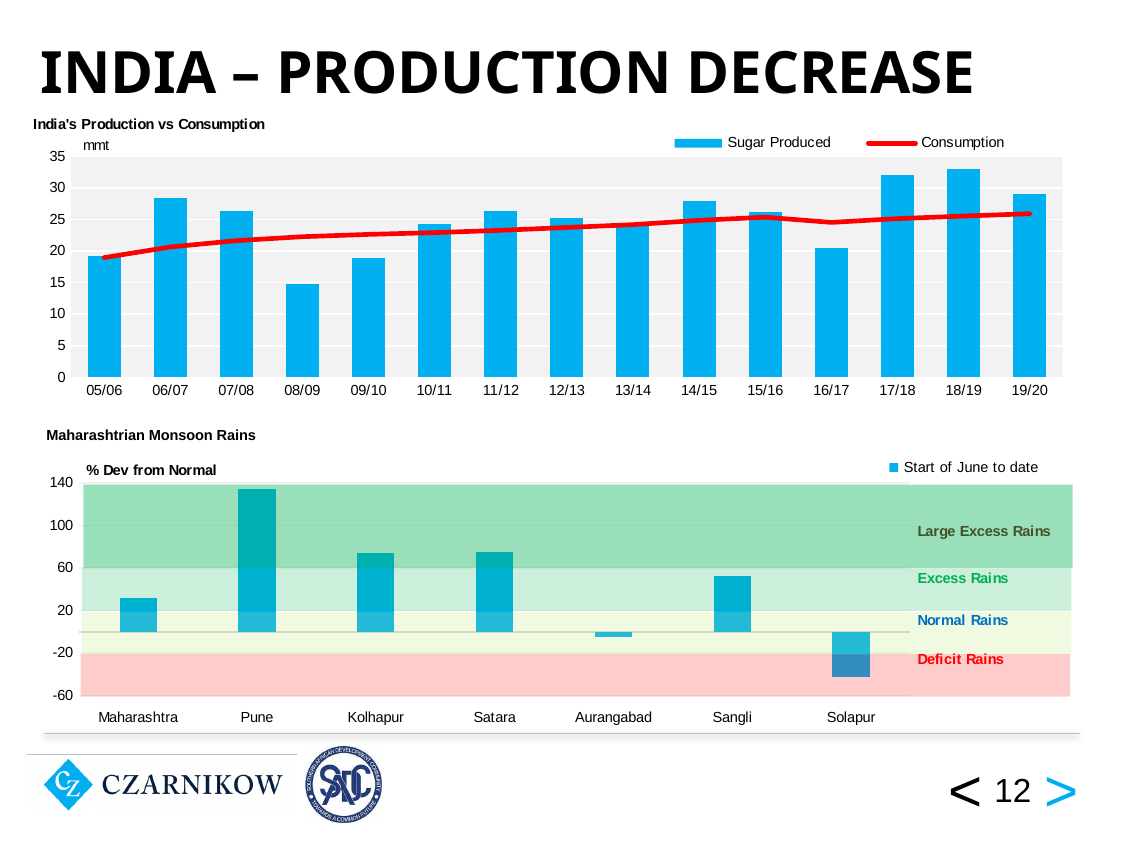
In the top chart, 'India's Production vs Consumption', is the Sugar Produced value for 08/09 greater or less than 20? less In the bottom chart, 'Maharashtrian Monsoon Rains', how many regions are shown on the x axis? 7 In the top chart, 'India's Production vs Consumption', which season has the highest Sugar Produced bar? 18/19 In the top chart, 'India's Production vs Consumption', which season has the lowest Sugar Produced bar? 08/09 In the bottom chart, 'Maharashtrian Monsoon Rains', which region has the highest % deviation from normal? Pune In the top chart, 'India's Production vs Consumption', what unit is shown on the y axis? mmt In the top chart, 'India's Production vs Consumption', how many seasons are shown on the x axis? 15 In the top chart, 'India's Production vs Consumption', is the Sugar Produced value for 18/19 greater or less than 30? greater In the top chart, 'India's Production vs Consumption', how many series does the legend list? 2 In the bottom chart, 'Maharashtrian Monsoon Rains', which region has the lowest % deviation from normal? Solapur In the bottom chart, 'Maharashtrian Monsoon Rains', is the value for Pune greater or less than 100? greater What kind of chart is the top chart, 'India's Production vs Consumption'? A bar chart with a line